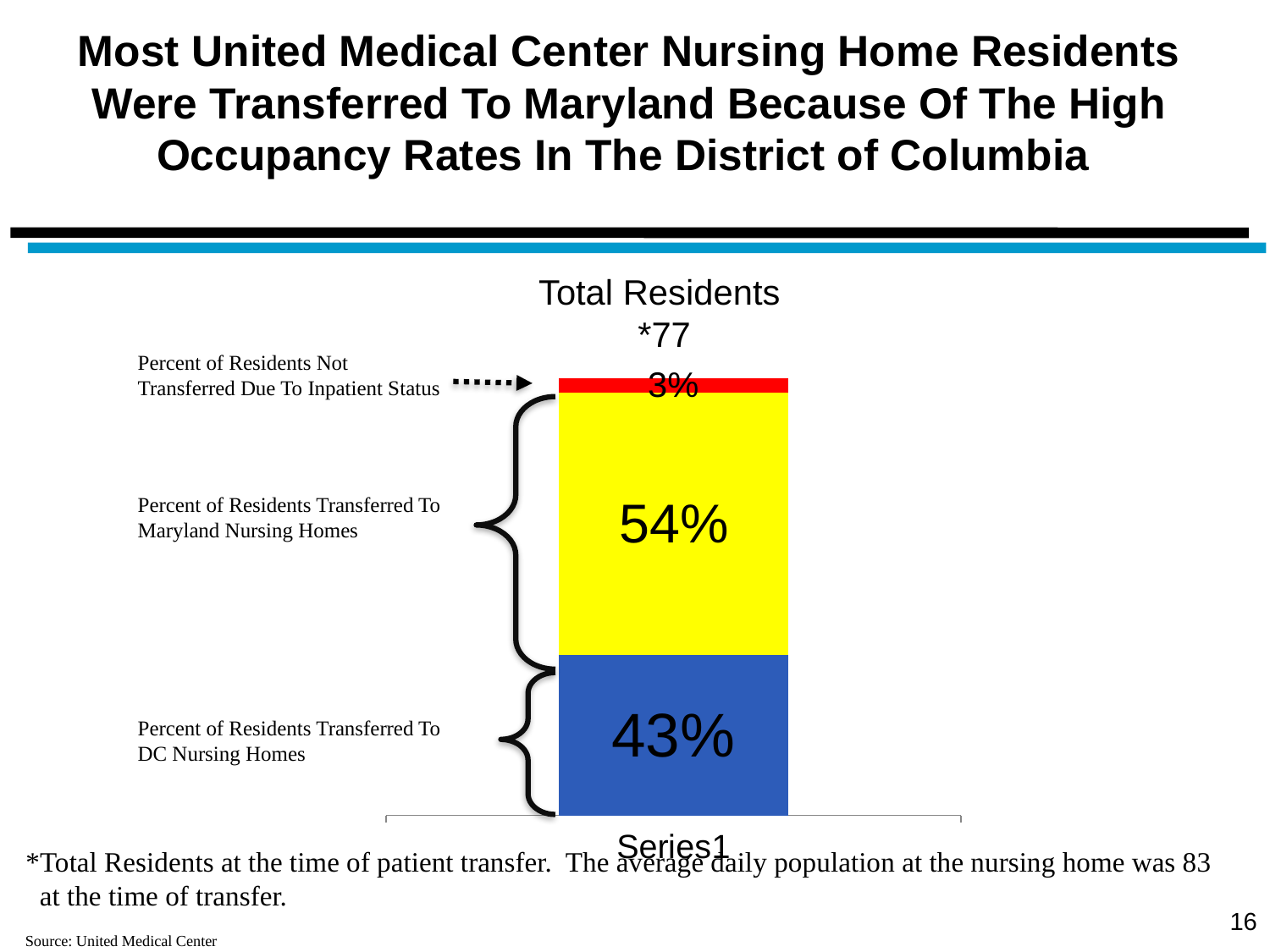
What is the total number of residents shown in the chart title? 77 What kind of chart is shown on the slide? Stacked bar chart Which is larger: the percentage transferred to Maryland nursing homes or the percentage transferred to DC nursing homes? Maryland nursing homes Which segment of the stacked bar is the smallest? Percent of Residents Not Transferred Due To Inpatient Status What is the difference between the percentage transferred to Maryland nursing homes and the percentage transferred to DC nursing homes? 11% What is the total of the three segments in the stacked bar? 100% What percentage of residents were transferred to DC nursing homes? 43% What percentage of residents were transferred to Maryland nursing homes? 54% What colour is the segment representing residents transferred to DC nursing homes? Blue How many segments make up the stacked bar? 3 Which segment of the stacked bar is the largest? Percent of Residents Transferred To Maryland Nursing Homes What percentage of residents were not transferred due to inpatient status? 3%